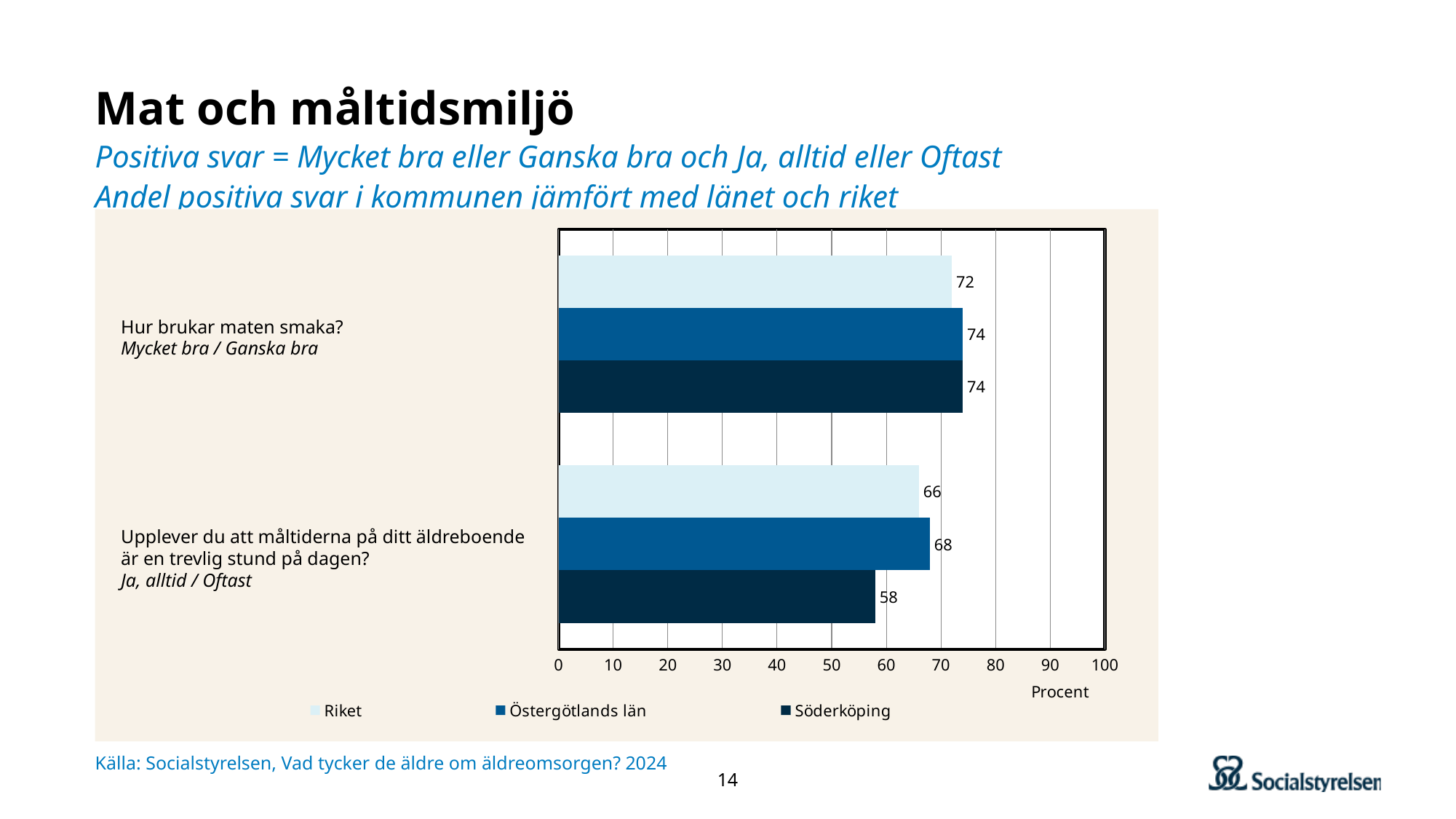
What is the value for Riket on the question "Upplever du att måltiderna på ditt äldreboende är en trevlig stund på dagen?"? 66 Which is larger for Riket: the value for "Hur brukar maten smaka?" or the value for "Upplever du att måltiderna på ditt äldreboende är en trevlig stund på dagen?"? Hur brukar maten smaka? Is the value for Söderköping on "Upplever du att måltiderna på ditt äldreboende är en trevlig stund på dagen?" greater or less than 60? less How many series does the legend list? 3 What is the value for Östergötlands län on the question "Hur brukar maten smaka?"? 74 What is the value for Söderköping on the question "Upplever du att måltiderna på ditt äldreboende är en trevlig stund på dagen?"? 58 Which series has the lowest value on the question "Hur brukar maten smaka?"? Riket What unit is shown on the x axis of the chart? Procent What is the difference between Östergötlands län and Söderköping on the question "Upplever du att måltiderna på ditt äldreboende är en trevlig stund på dagen?"? 10 What kind of chart is shown on the slide? Bar chart What is the value for Söderköping on the question "Hur brukar maten smaka?"? 74 Which series has the lowest value on the question "Upplever du att måltiderna på ditt äldreboende är en trevlig stund på dagen?"? Söderköping